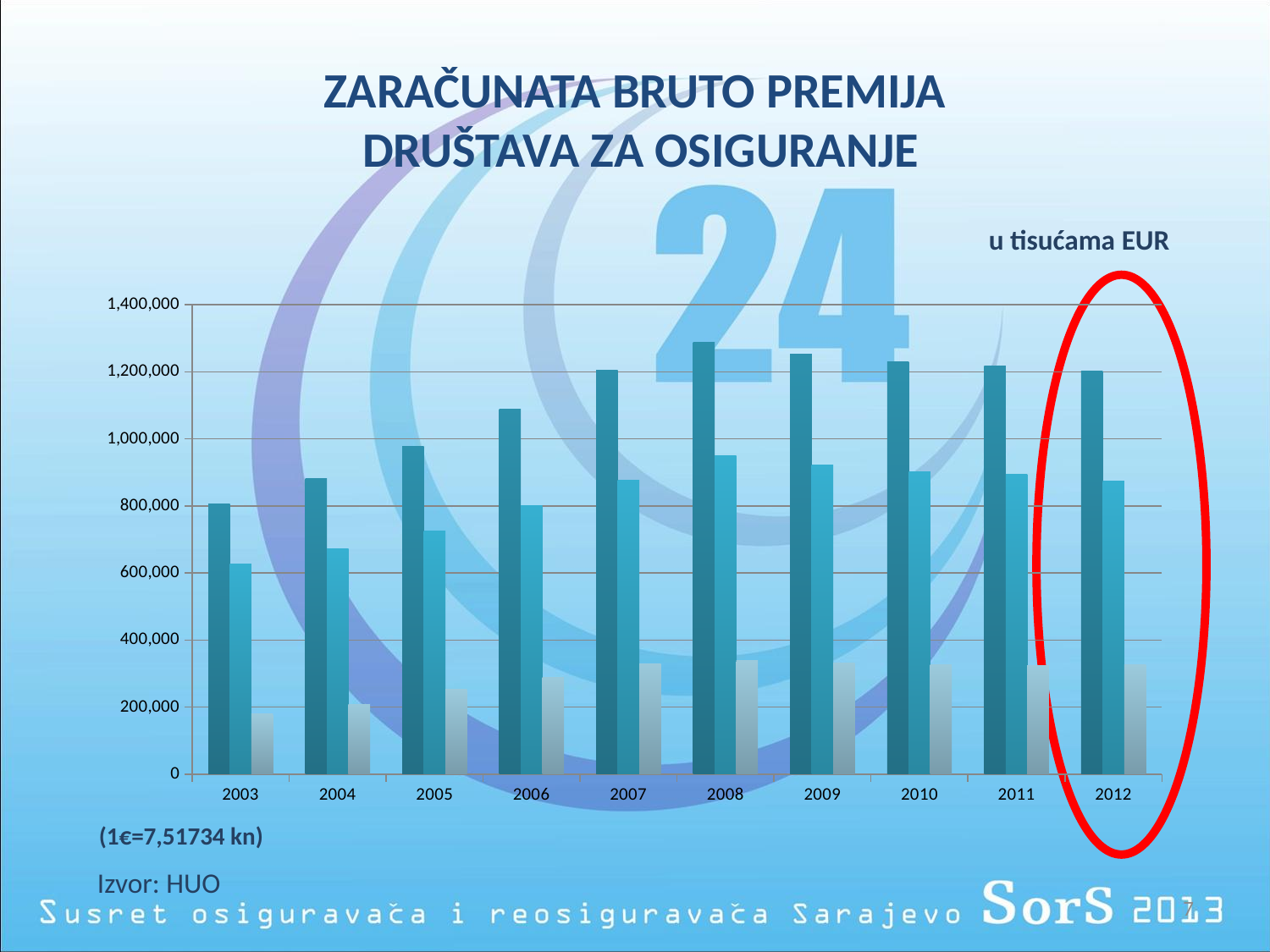
Which year has the larger dark teal bar, 2003 or 2008? 2008 Is the dark teal bar for 2003 greater or less than 1,000,000? less In which year is the dark teal (first) bar the lowest? 2003 How many years are shown on the x axis of the chart? 10 In which year is the dark teal (first) bar the highest? 2008 Is the light teal (second) bar for 2012 greater or less than 800,000? greater Is the dark teal bar for 2008 greater or less than 1,200,000? greater In what unit are the values in the chart expressed, according to the note above the chart? u tisućama EUR How many bars are plotted for each year in the chart? 3 Does the dark teal series rise or fall from 2003 to 2008? rise What kind of chart is shown on the slide? bar chart